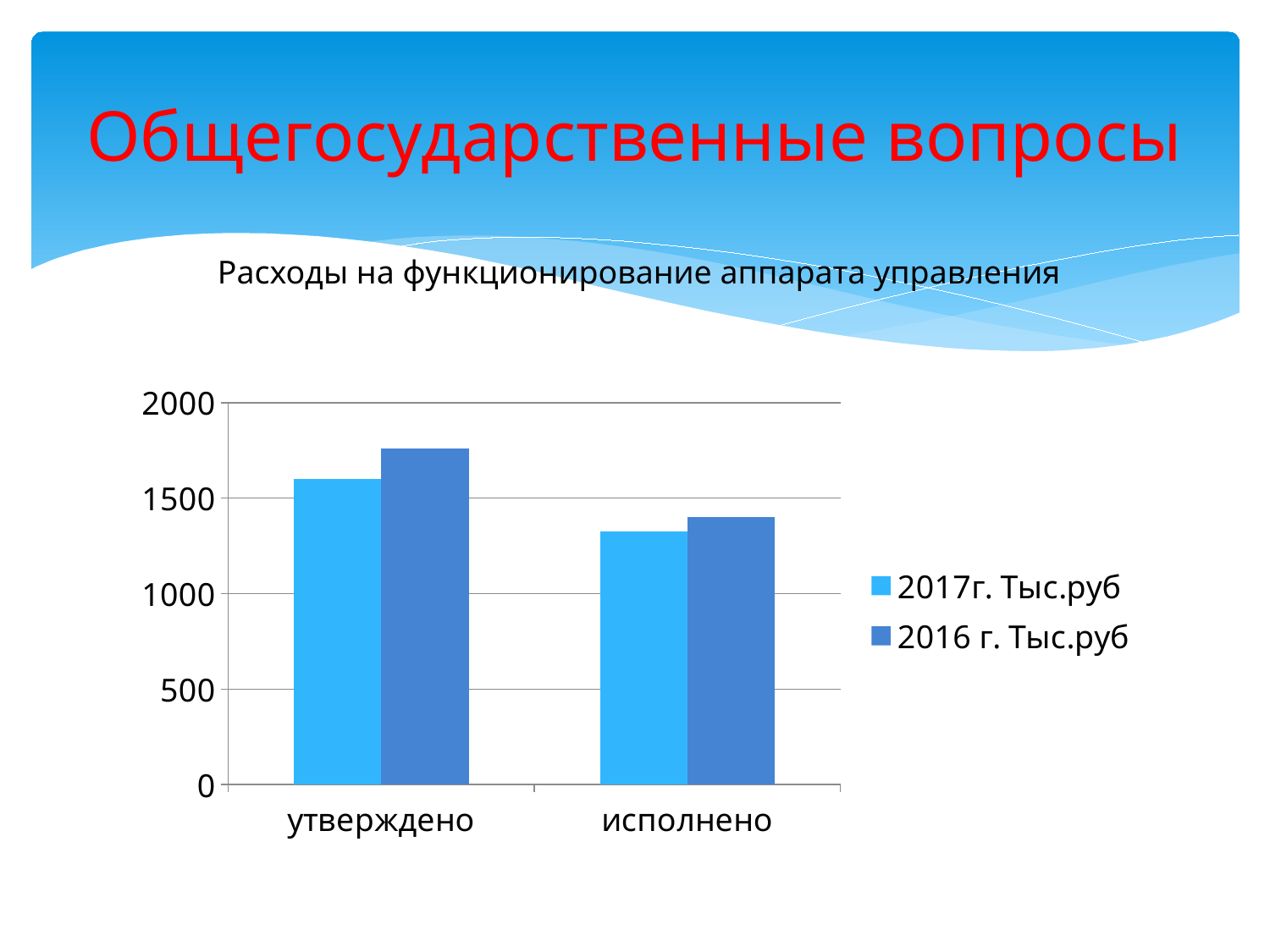
Is the value for утверждено in the 2017г. Тыс.руб series greater or less than 1500? greater How many categories are shown on the x axis? 2 For утверждено, which series has the larger value, 2017г. Тыс.руб or 2016 г. Тыс.руб? 2016 г. Тыс.руб How many series does the legend list? 2 Is the value for исполнено in the 2016 г. Тыс.руб series greater or less than 1000? greater Do the values for the 2017г. Тыс.руб series rise or fall from утверждено to исполнено? fall Is the value for утверждено in the 2016 г. Тыс.руб series greater or less than 2000? less What kind of chart is shown on the slide? bar chart What is the subtitle above the chart? Расходы на функционирование аппарата управления Which bar is the shortest in the chart? 2017г. Тыс.руб, исполнено Which bar is the tallest in the chart? 2016 г. Тыс.руб, утверждено